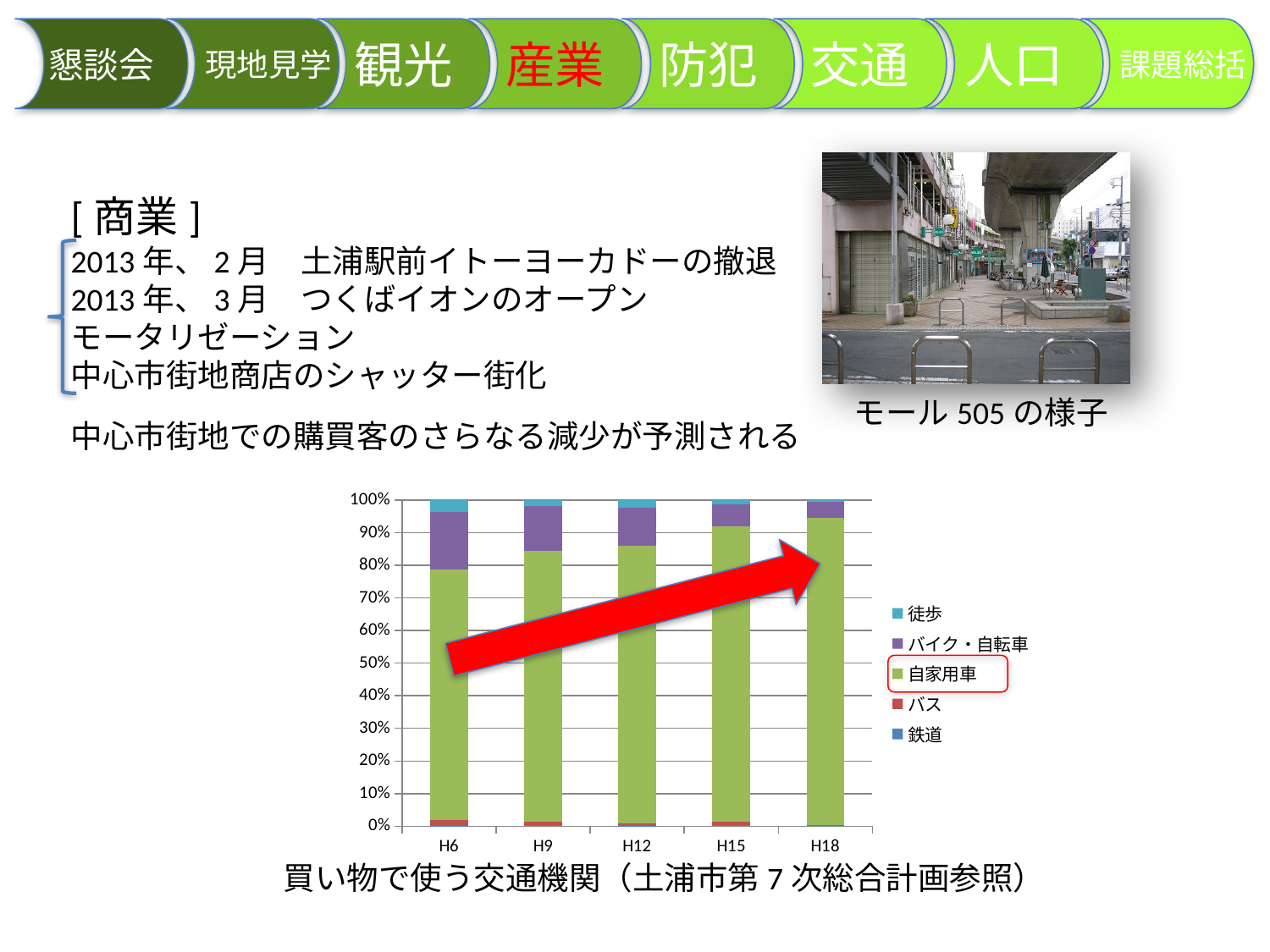
Which year has a larger share of バイク・自転車, H6 or H18? H6 Is the share of 自家用車 in H18 greater or less than 90%? greater Which legend entry is highlighted with a red box? 自家用車 Which year has a larger share of 自家用車, H9 or H15? H15 Does the share of 自家用車 rise or fall from H6 to H18? rise In which year is the share of 自家用車 the highest? H18 How many series does the chart's legend list? 5 Is the share of 自家用車 in H6 greater or less than 70%? greater What kind of chart is shown on the slide? stacked bar chart In which year is the share of 自家用車 the lowest? H6 What is the caption below the chart? 買い物で使う交通機関（土浦市第7次総合計画参照） How many categories (years) are shown on the x axis of the chart? 5